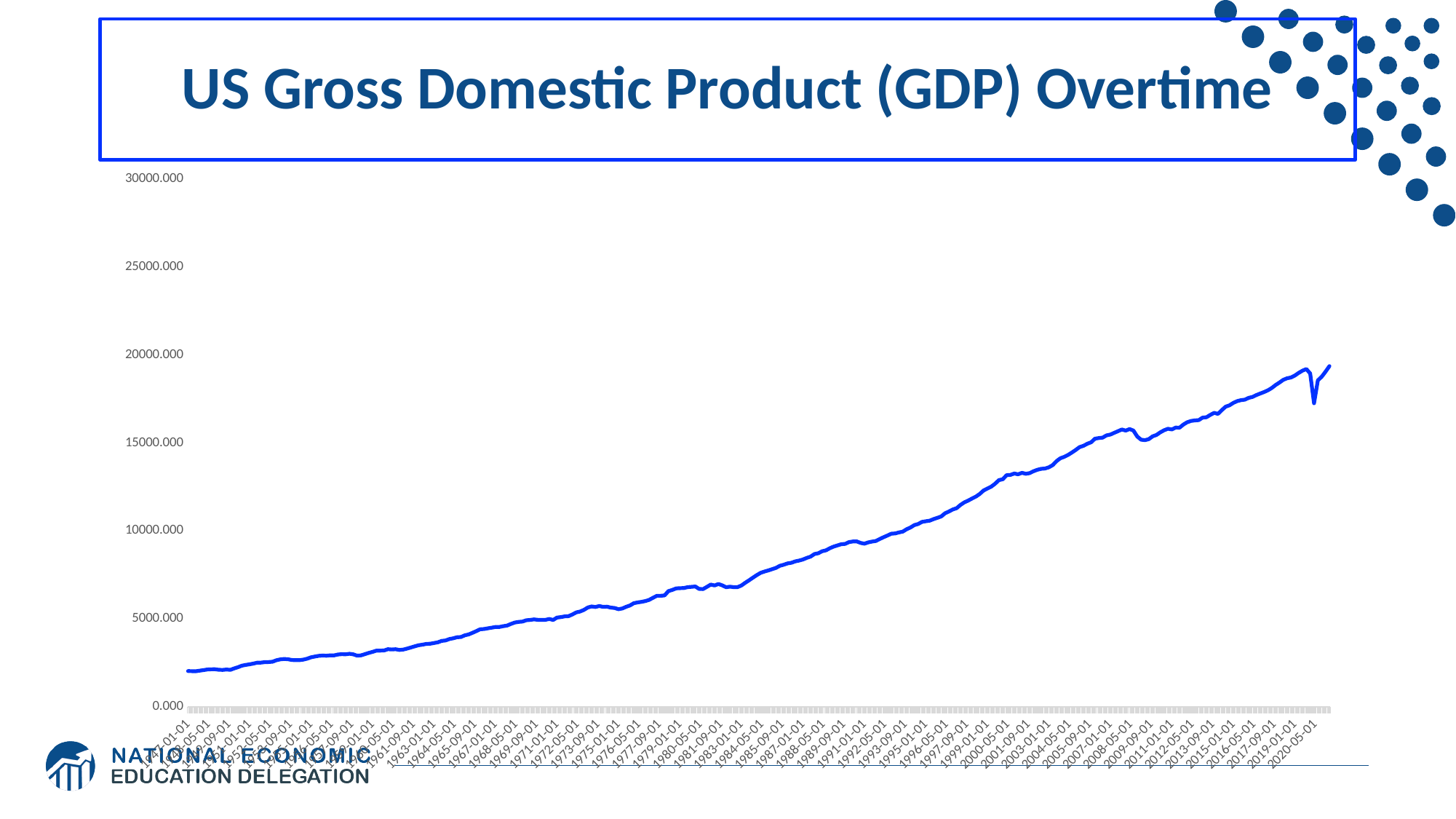
What is the highest tick value shown on the y axis? 30000.000 Is the value for 2004-01-01 greater or less than 10000.000? greater Is the value for 1964-05-01 greater or less than 5000.000? less What is the title of the chart? US Gross Domestic Product (GDP) Overtime What kind of chart is shown on the slide? line chart Is the value at the right end of the line (2020-05-01) greater or less than 20000.000? less How many lines are plotted on the chart? 1 Do the values generally rise or fall along the x axis from left to right? rise